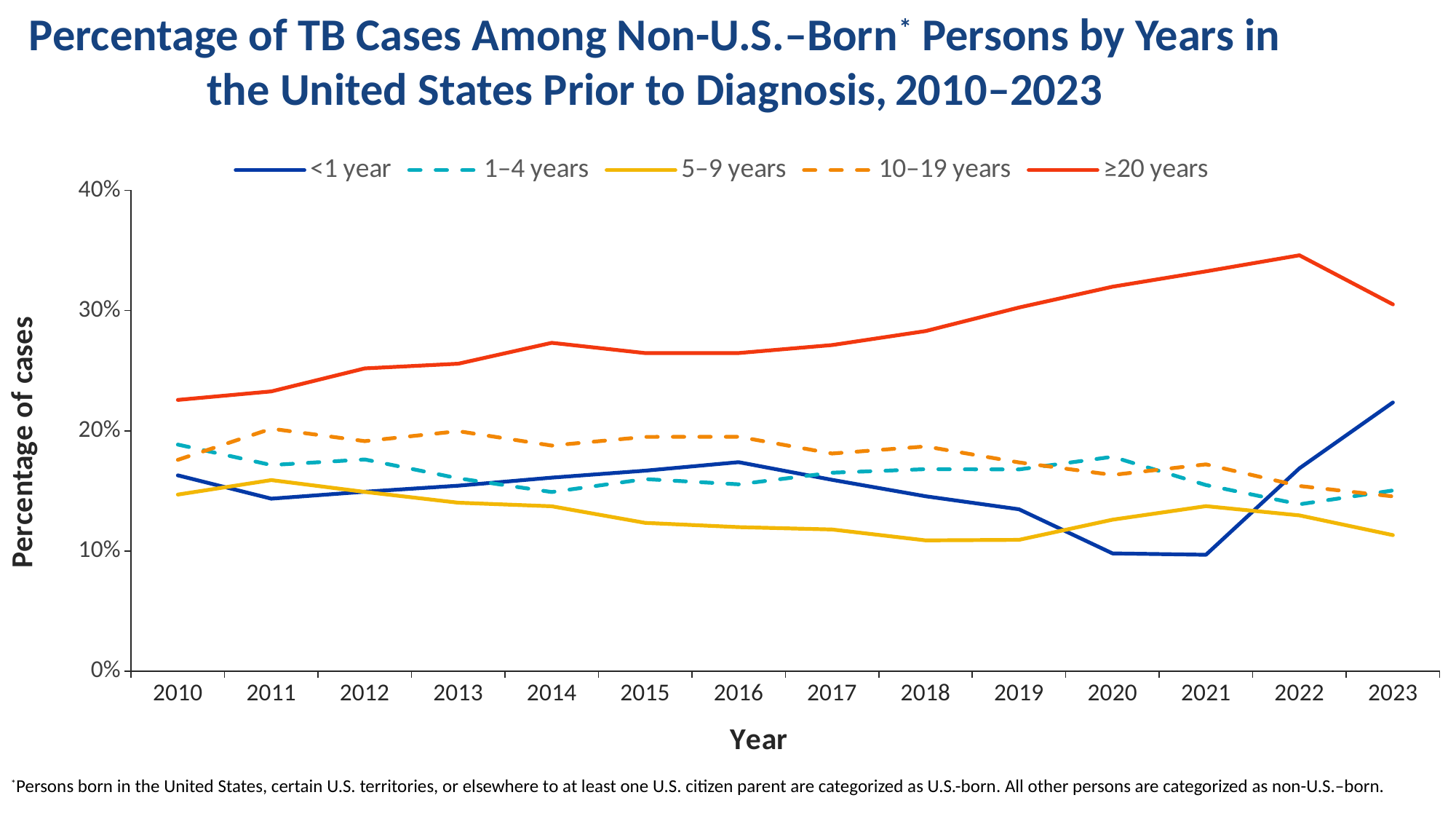
Which series has the highest value in 2023? ≥20 years Does the ≥20 years series rise or fall from 2010 to 2022? rise Which series has the lowest value in 2020? <1 year Is the value for ≥20 years in 2022 greater or less than 30%? greater Which series has the lowest value in 2023? 5–9 years Is the value for 5–9 years in 2023 greater or less than 10%? greater How many series does the legend list? 5 In 2021, which is larger: the value for <1 year or the value for 5–9 years? 5–9 years What is the label on the y axis? Percentage of cases What kind of chart is shown on the slide? line chart Is the value for <1 year in 2023 greater or less than 20%? greater How many years are plotted along the x axis? 14